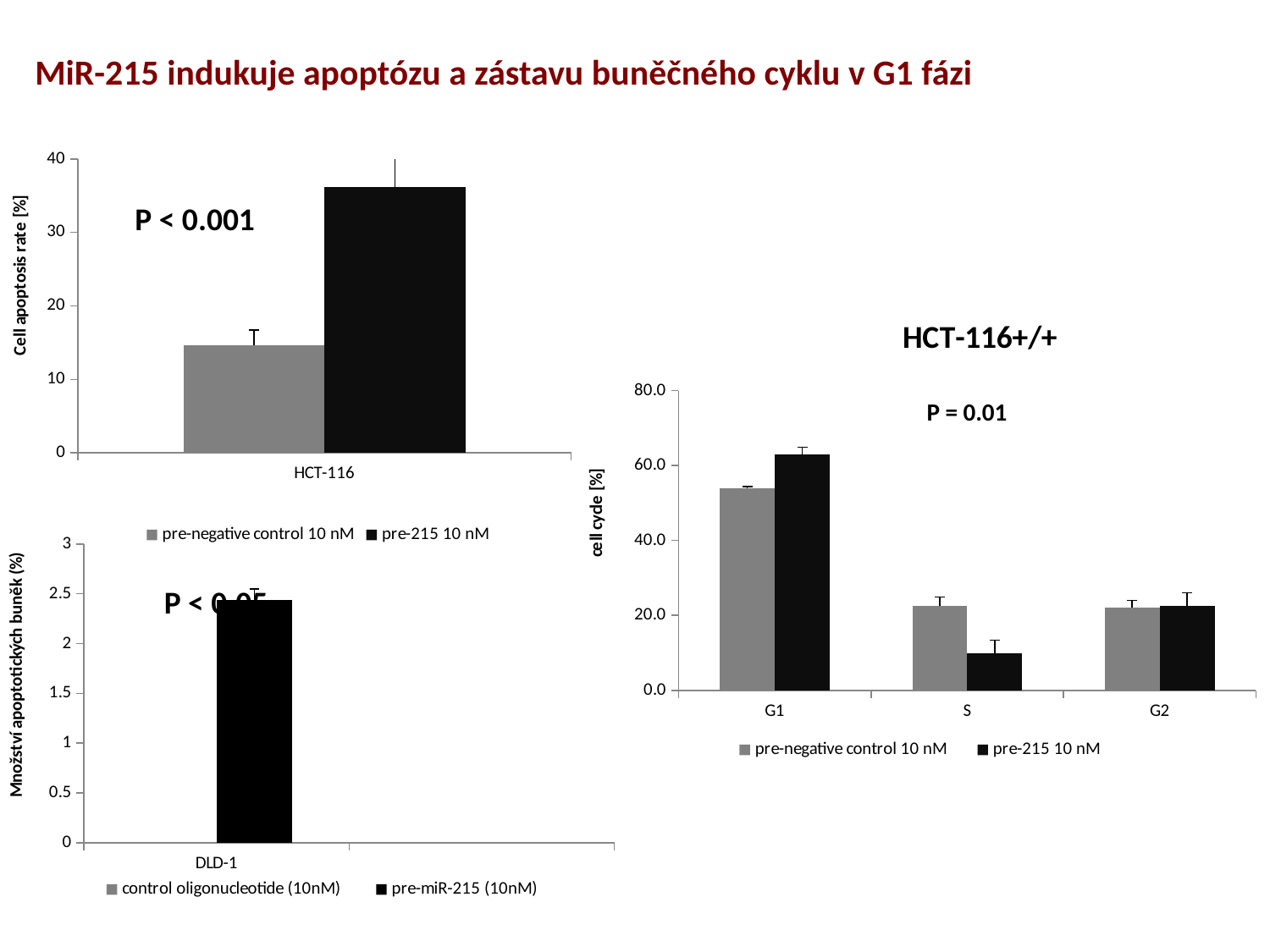
In the right chart (HCT-116+/+), is the value for pre-215 10 nM in G1 greater or less than 60.0? greater In the right chart (HCT-116+/+), how many cell cycle phases are shown on the x axis? 3 In the right chart (HCT-116+/+), which phase has the lowest value for pre-215 10 nM? S In the top-left chart (Cell apoptosis rate), is the value for pre-negative control 10 nM greater or less than 20? less In the top-left chart (Cell apoptosis rate), is the value for pre-215 10 nM greater or less than 30? greater In the bottom-left chart (DLD-1), how many series does the legend list? 2 In the top-left chart (Cell apoptosis rate), which series has the higher value for HCT-116: pre-negative control 10 nM or pre-215 10 nM? pre-215 10 nM In the right chart (HCT-116+/+), which series has the larger value in the S phase: pre-negative control 10 nM or pre-215 10 nM? pre-negative control 10 nM In the right chart (HCT-116+/+), which phase has the highest value for pre-215 10 nM? G1 In the top-left chart (Cell apoptosis rate), what P value is shown? P < 0.001 What kind of chart is the right chart (HCT-116+/+)? bar chart